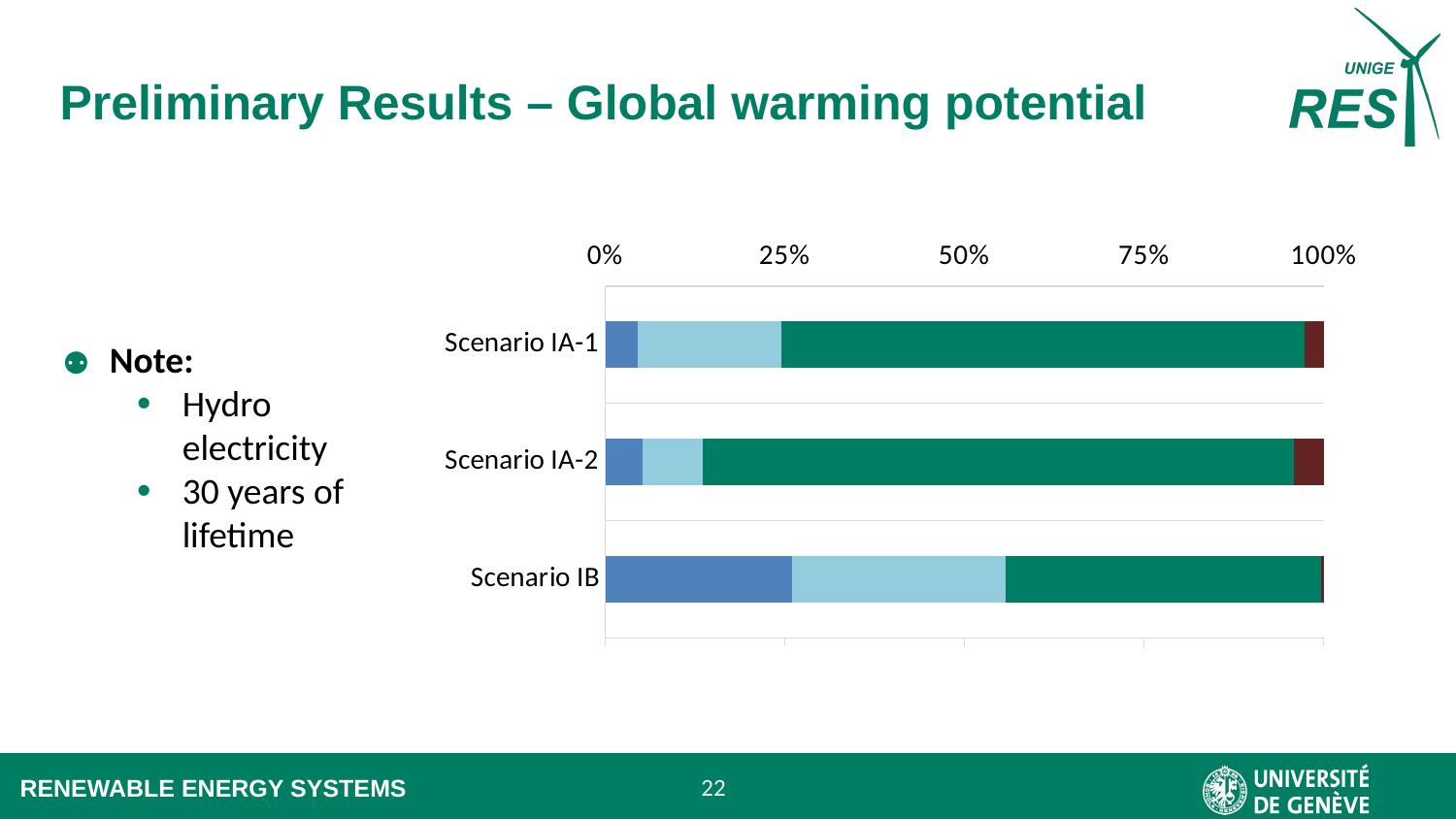
What kind of chart is shown on the slide? Stacked bar chart How many coloured segments make up each bar in the chart? 4 Which scenario has the smallest dark red segment? Scenario IB In Scenario IA-2, is the combined share of the dark blue and light blue segments greater or less than 25%? less How many scenarios (categories) are plotted in the chart? 3 Which scenario has the smallest light blue segment? Scenario IA-2 Which scenario has the smallest dark green segment? Scenario IB What is the highest value shown on the chart's percentage axis? 100% In Scenario IB, is the combined share of the dark blue and light blue segments greater or less than 50%? greater